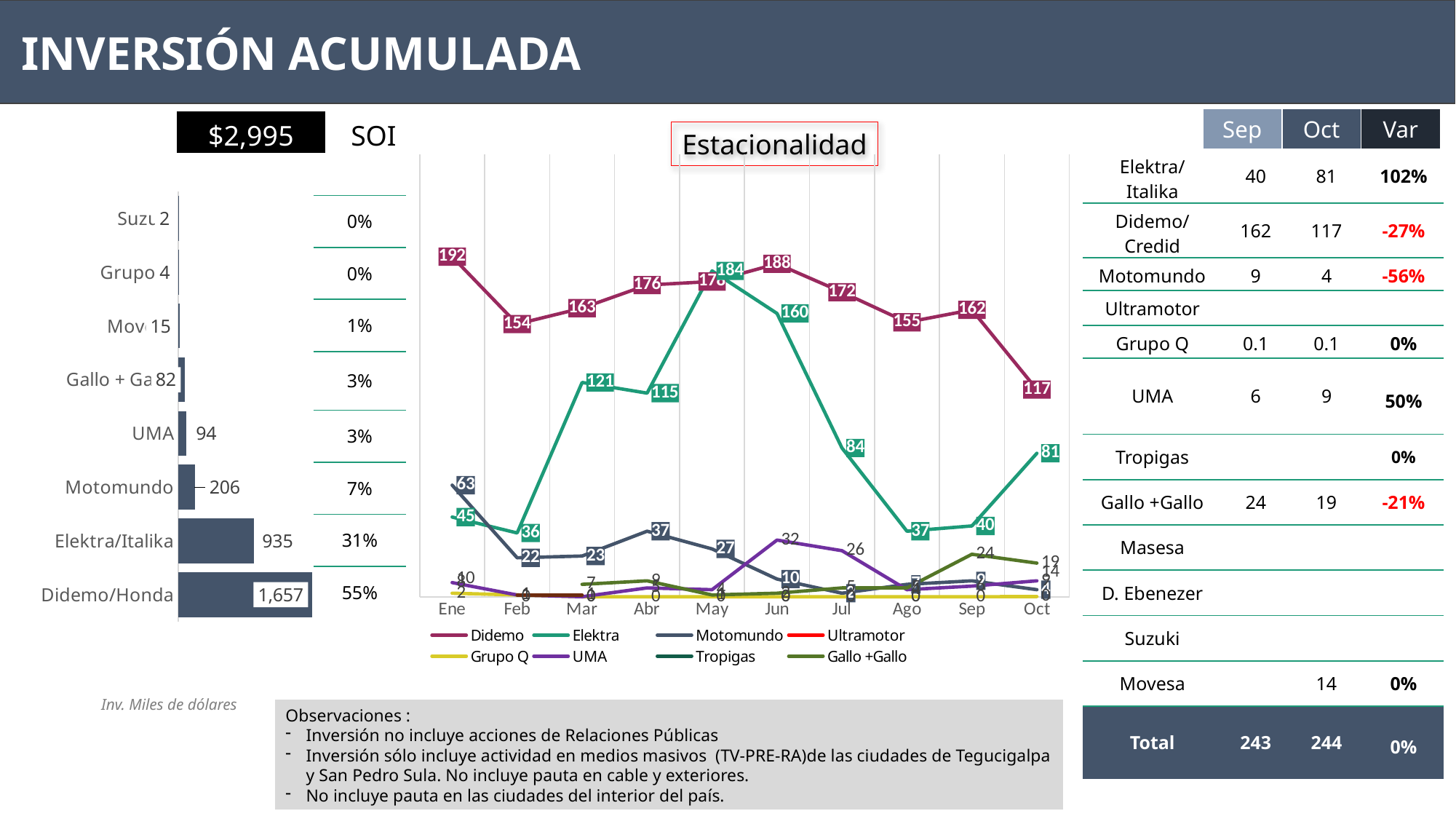
In the bar chart on the left, what is the difference between the values for Didemo/Honda and Elektra/Italika? 722 What kind of chart is the chart on the left? Bar chart In the bar chart on the left, how many categories are shown? 8 In the Estacionalidad chart, is the value for Elektra higher in Sep or in Oct? Oct In the bar chart on the left, what is the value for Didemo/Honda? 1,657 In the bar chart on the left, what is the value for Elektra/Italika? 935 In the Estacionalidad chart, what is the value for Elektra in May? 184 In the Estacionalidad chart, what is the difference between Didemo's value in Ene and in Oct? 75 In the bar chart on the left, which category has the highest value? Didemo/Honda In the Estacionalidad chart, in which month does Didemo reach its highest value? Ene In the Estacionalidad chart, how many series does the legend list? 8 In the Estacionalidad chart, what is the value for Didemo in Ene? 192